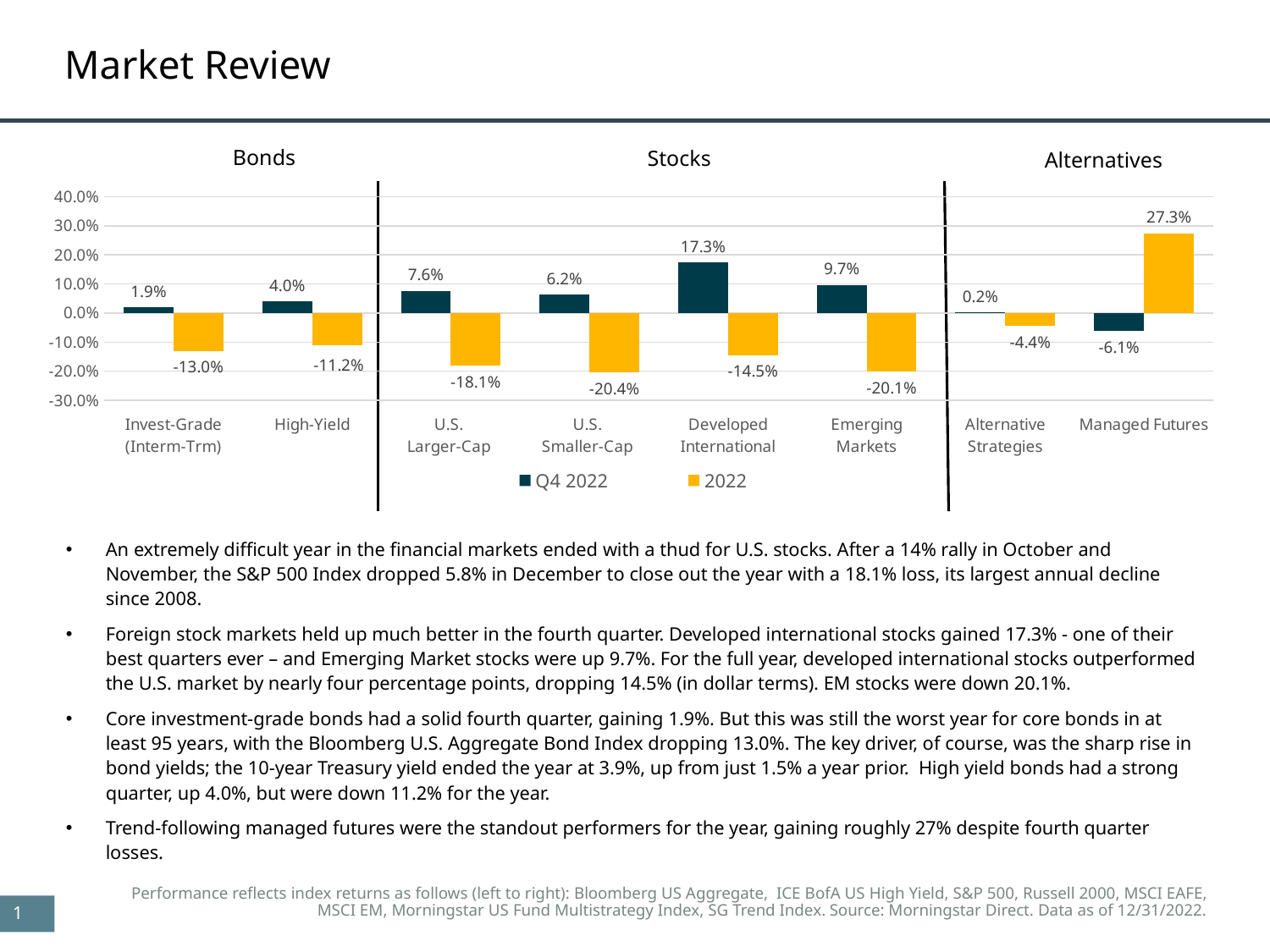
What is the 2022 value for U.S. Smaller-Cap? -20.4% Which is larger, the 2022 value for Invest-Grade (Interm-Trm) or the 2022 value for High-Yield? High-Yield What is the difference between the Q4 2022 values for High-Yield and Invest-Grade (Interm-Trm)? 2.1% How many series does the legend list? 2 What is the Q4 2022 value for Developed International? 17.3% What is the Q4 2022 value for Alternative Strategies? 0.2% Which category has the lowest 2022 value? U.S. Smaller-Cap How many categories are shown on the x axis of the chart? 8 Which category has the highest Q4 2022 value? Developed International What is the 2022 value for Managed Futures? 27.3% What are the three group headings shown above the chart? Bonds, Stocks, Alternatives What kind of chart is shown on the slide? Bar chart